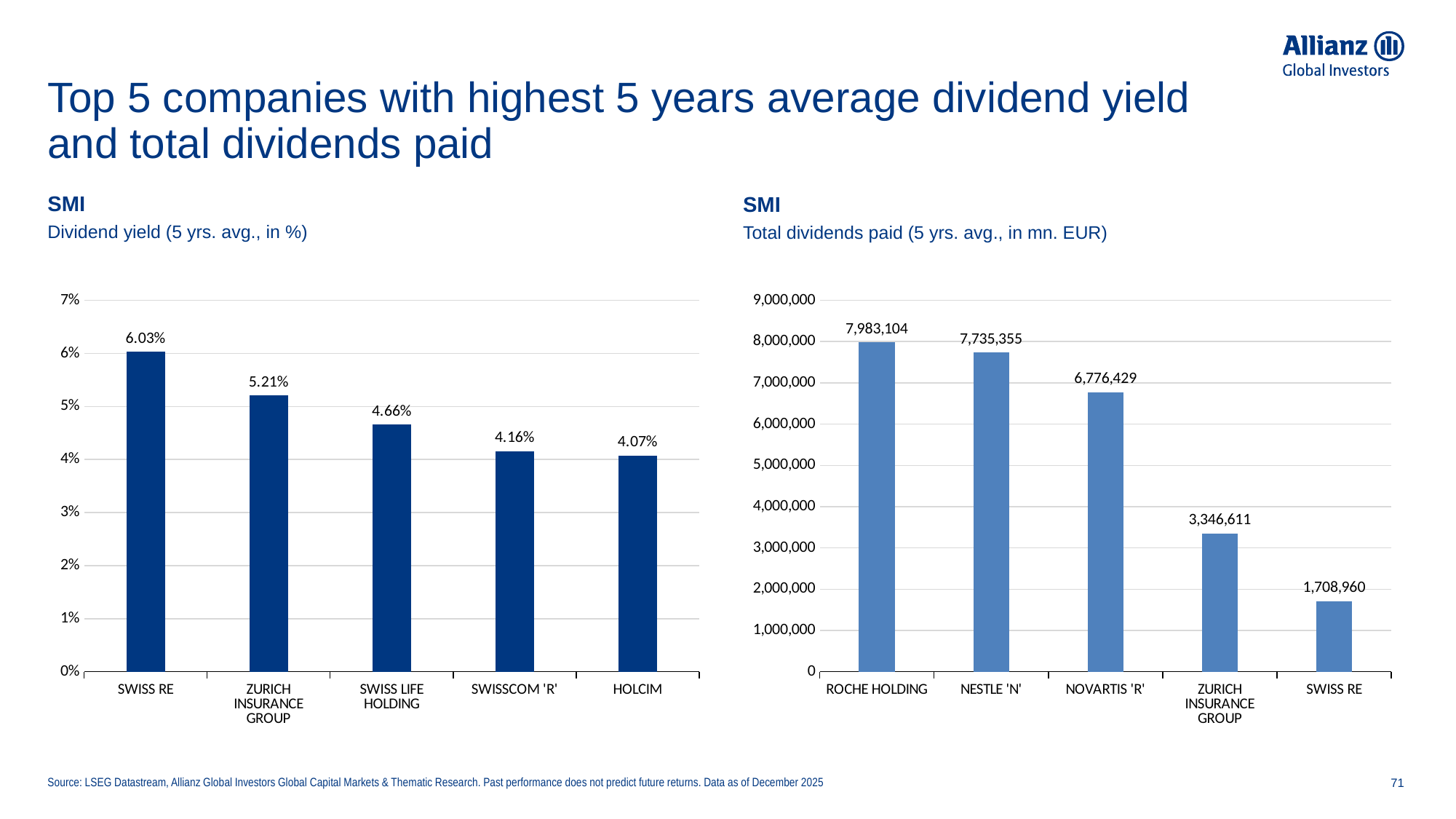
In the right chart (Total dividends paid, 5 yrs. avg., in mn. EUR), what is the value for NOVARTIS 'R'? 6,776,429 In the left chart (Dividend yield, 5 yrs. avg., in %), what is the difference between the dividend yields of SWISS RE and ZURICH INSURANCE GROUP? 0.82% In the left chart (Dividend yield, 5 yrs. avg., in %), what is the dividend yield for SWISS RE? 6.03% In the right chart (Total dividends paid, 5 yrs. avg., in mn. EUR), which is larger: ZURICH INSURANCE GROUP or SWISS RE? ZURICH INSURANCE GROUP What type of chart is the right chart (Total dividends paid, 5 yrs. avg., in mn. EUR)? bar chart In the left chart (Dividend yield, 5 yrs. avg., in %), which company has the lowest dividend yield? HOLCIM In the right chart (Total dividends paid, 5 yrs. avg., in mn. EUR), what is the value for SWISS RE? 1,708,960 In the right chart (Total dividends paid, 5 yrs. avg., in mn. EUR), what is the difference between ROCHE HOLDING and NESTLE 'N'? 247,749 In the right chart (Total dividends paid, 5 yrs. avg., in mn. EUR), which company has the highest value? ROCHE HOLDING In the left chart (Dividend yield, 5 yrs. avg., in %), do the values rise or fall from left to right? fall In the left chart (Dividend yield, 5 yrs. avg., in %), what is the dividend yield for SWISS LIFE HOLDING? 4.66% In the left chart (Dividend yield, 5 yrs. avg., in %), how many companies are shown? 5